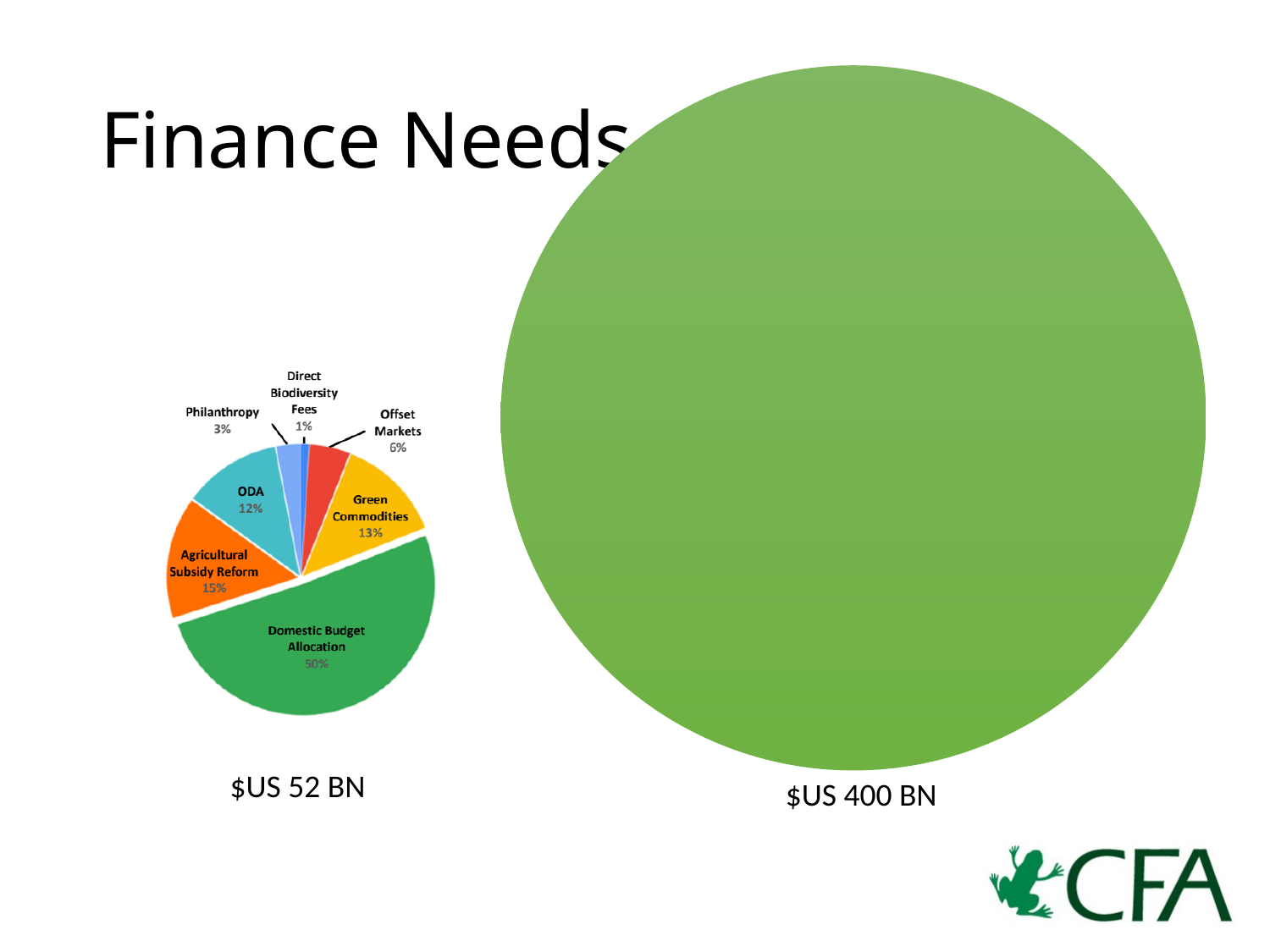
In the pie chart, which is larger: Agricultural Subsidy Reform or ODA? Agricultural Subsidy Reform In the pie chart, what share does ODA have? 12% What is the difference in percentage points between Green Commodities and Philanthropy in the pie chart? 10 What type of chart is shown on the left of the slide? pie chart Which slice of the pie chart is the largest? Domestic Budget Allocation In the pie chart, what share does Domestic Budget Allocation have? 50% In the pie chart, what share does Offset Markets have? 6% Which slice of the pie chart is the smallest? Direct Biodiversity Fees In the pie chart, what share does Direct Biodiversity Fees have? 1% In the pie chart, what share does Green Commodities have? 13% In the pie chart, what share does Agricultural Subsidy Reform have? 15% How many slices does the pie chart have? 7